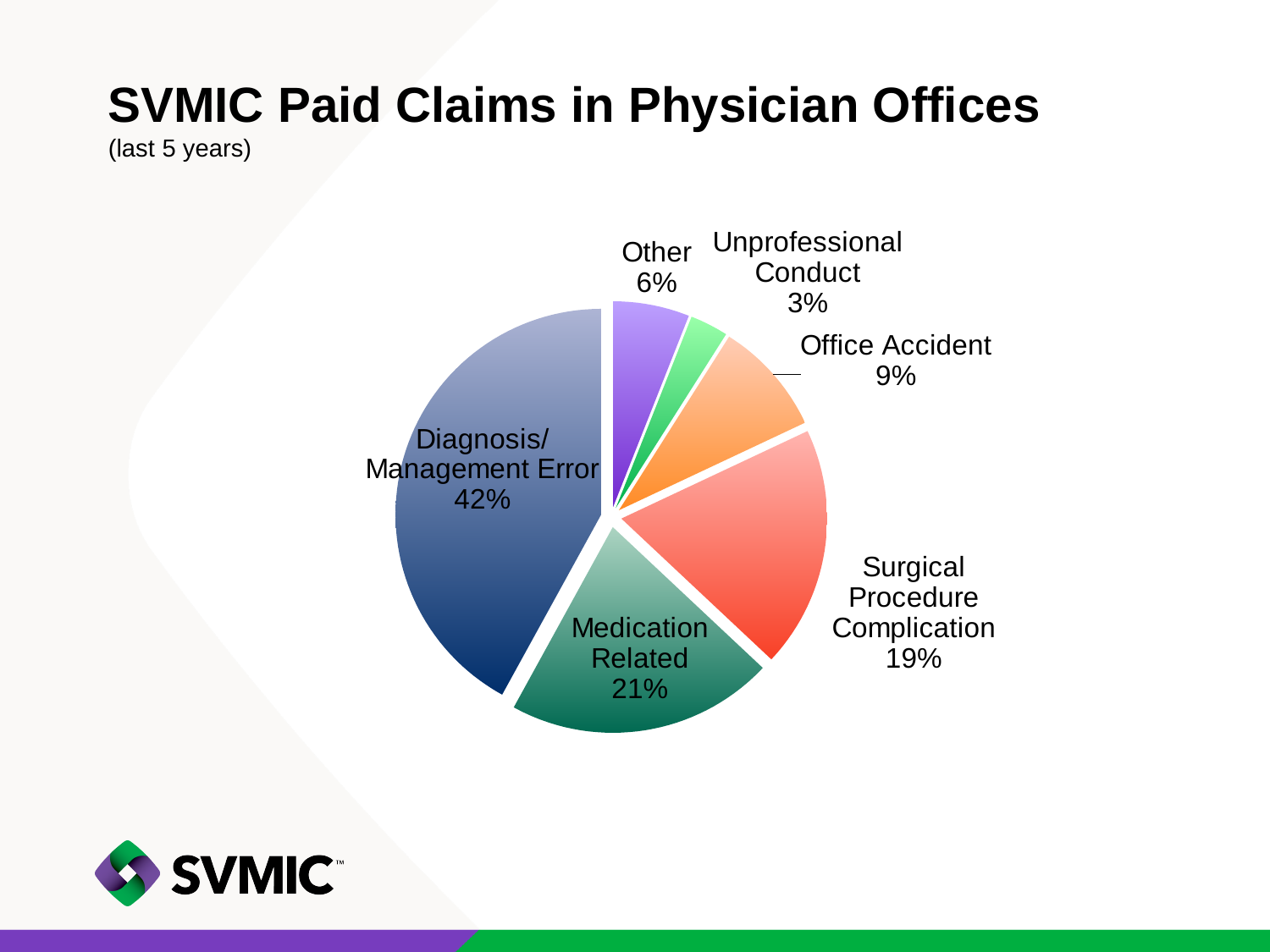
How many categories are shown in the pie chart? 6 What kind of chart is shown on the slide? pie chart What percentage of paid claims is Medication Related? 21% What share of paid claims is attributed to Unprofessional Conduct? 3% How many percentage points larger is the Diagnosis/Management Error share than the Medication Related share? 21 What time period does the chart cover, according to the subtitle? last 5 years What share of paid claims is attributed to Diagnosis/Management Error? 42% What percentage of paid claims is attributed to Office Accident? 9% Which category accounts for the largest share of paid claims? Diagnosis/Management Error What share of paid claims is due to Surgical Procedure Complication? 19% Which is larger: the share for Office Accident or the share for Other? Office Accident Which category accounts for the smallest share of paid claims? Unprofessional Conduct